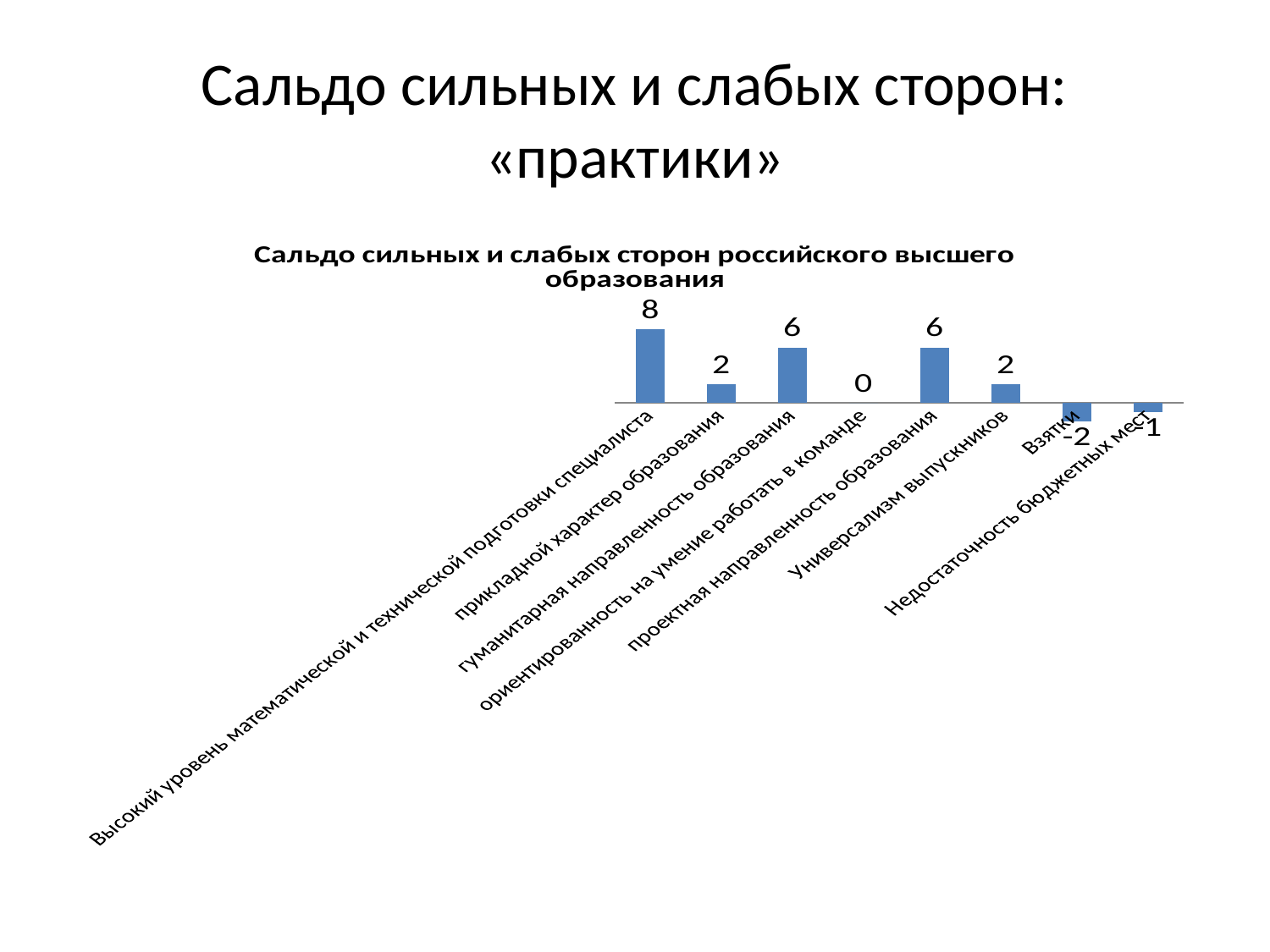
What is the value for «Недостаточность бюджетных мест»? -1 What is the title of the chart? Сальдо сильных и слабых сторон российского высшего образования Which category has the lowest value? Взятки How many categories have a negative value? 2 What is the value for «ориентированность на умение работать в команде»? 0 How many categories are shown in the chart? 8 Which category has the highest value? Высокий уровень математической и технической подготовки специалиста What is the difference between the values for «гуманитарная направленность образования» and «прикладной характер образования»? 4 What kind of chart is shown on the slide? Bar chart Which is larger: the value for «проектная направленность образования» or the value for «Универсализм выпускников»? проектная направленность образования What is the value for «Высокий уровень математической и технической подготовки специалиста»? 8 What is the value for «Взятки»? -2